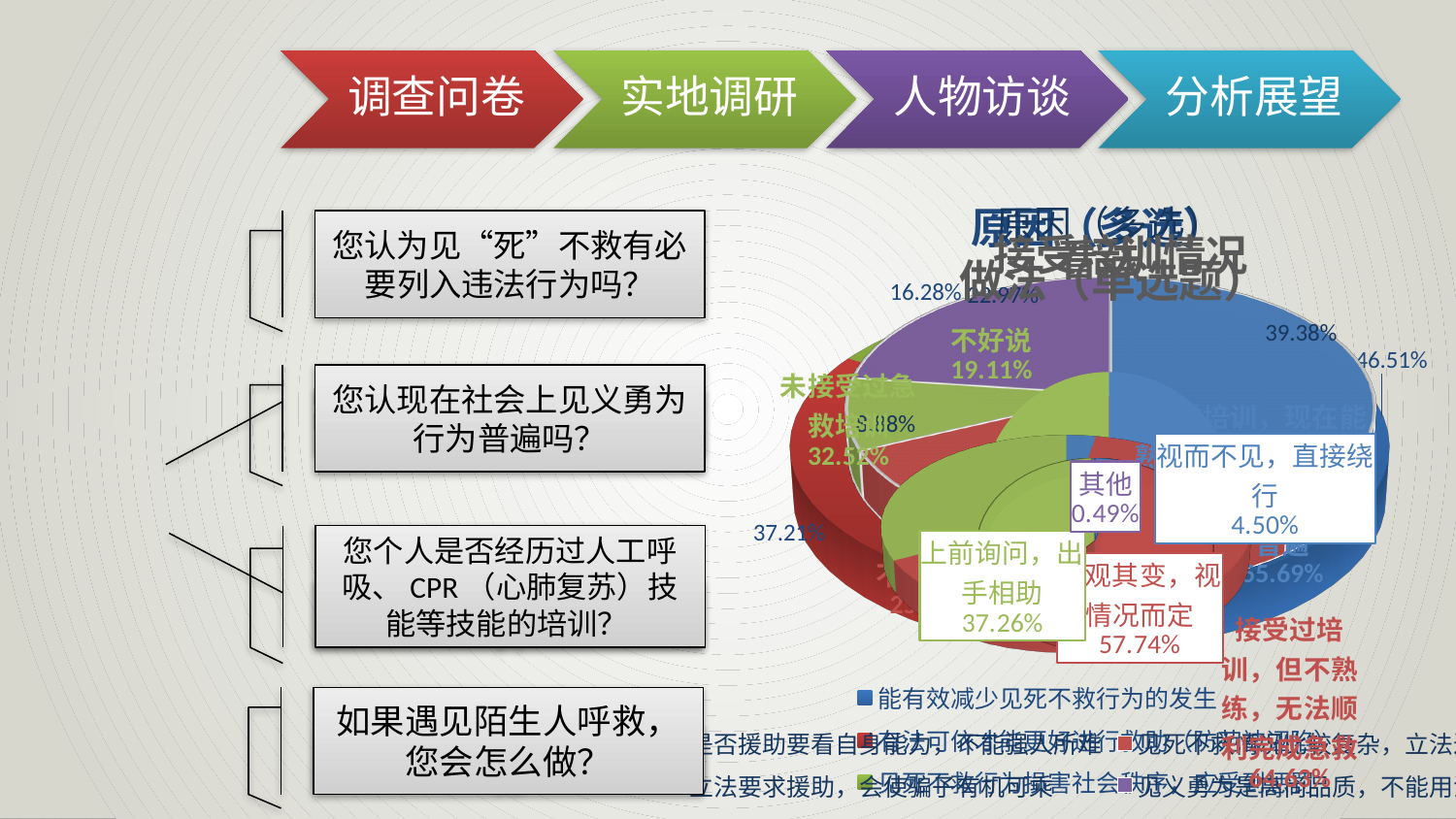
How many options are labelled in the 做法（单选题） pie chart? 4 What type of chart is the 做法（单选题） chart? pie chart In the 做法（单选题） pie chart, what percentage is shown for 上前询问，出手相助? 37.26% In the 做法（单选题） pie chart, which option has the smallest share? 其他 In the 接受培训情况 pie chart, what percentage is shown for 接受过培训，但不熟练，无法顺利完成急救? 64.63% In the 做法（单选题） pie chart, what percentage is shown for 其他? 0.49% In the 做法（单选题） pie chart, which option has the largest share? 远观其变，视情况而定